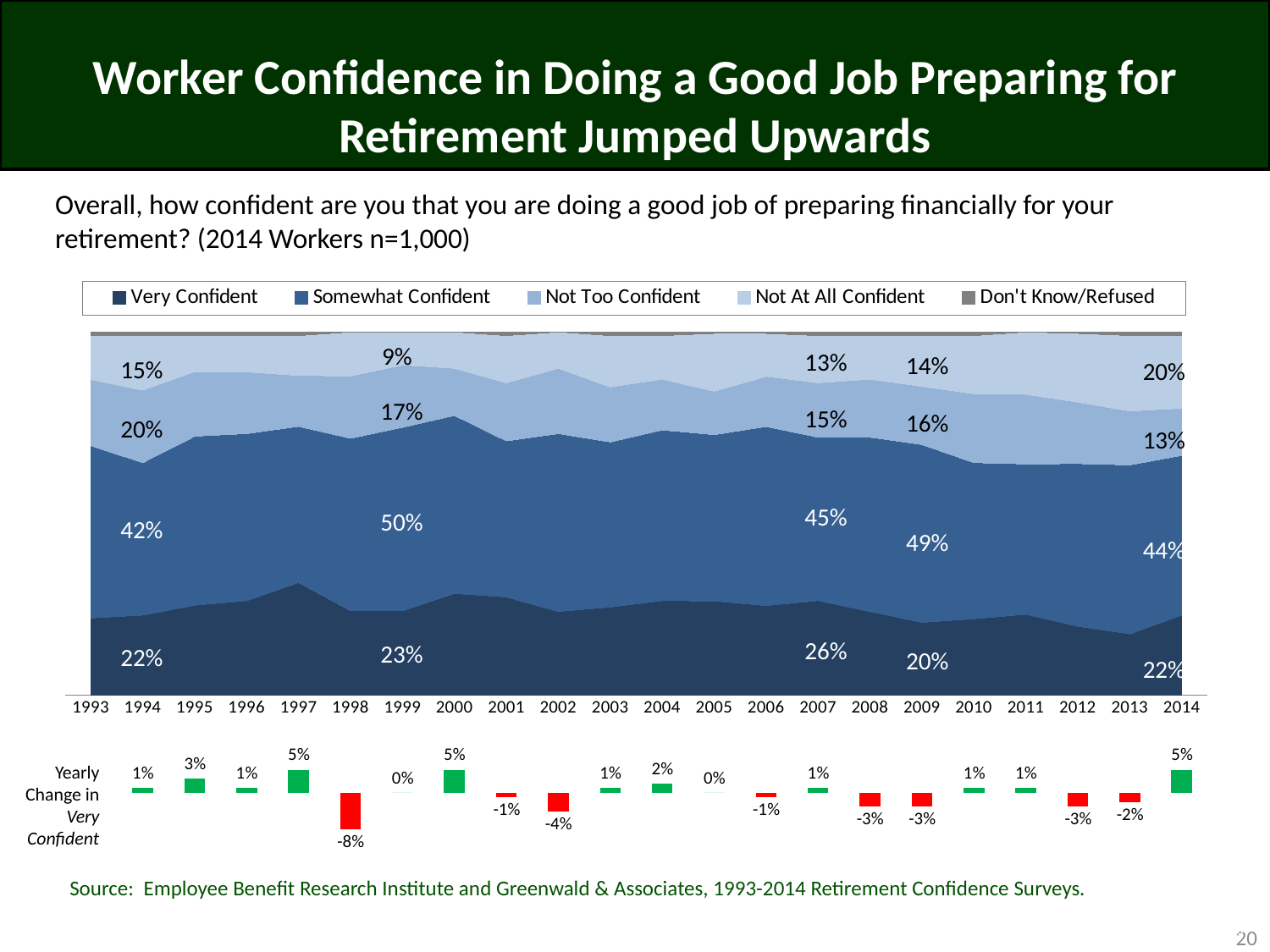
In the stacked area chart, what percentage of workers were Not At All Confident in 2014? 20% In the stacked area chart, which was larger in 2014: the Not Too Confident share or the Not At All Confident share? Not At All Confident In the stacked area chart, what percentage of workers were Not Too Confident in 2009? 16% What kind of chart is the main chart showing confidence levels from 1993 to 2014? Stacked area chart In the Yearly Change in Very Confident bar chart, which year shows the largest decrease? 1998 In the Yearly Change in Very Confident bar chart, what is the value for 2014? 5% In the stacked area chart, what percentage of workers were Somewhat Confident in 1999? 50% How many series does the legend of the stacked area chart list? 5 In the stacked area chart, what percentage of workers were Very Confident in 2014? 22% What kind of chart is the Yearly Change in Very Confident chart at the bottom of the slide? Bar chart In the Yearly Change in Very Confident bar chart, what is the value for 2002? -4% In the stacked area chart, what is the difference between the Very Confident share in 2007 and in 2009? 6%